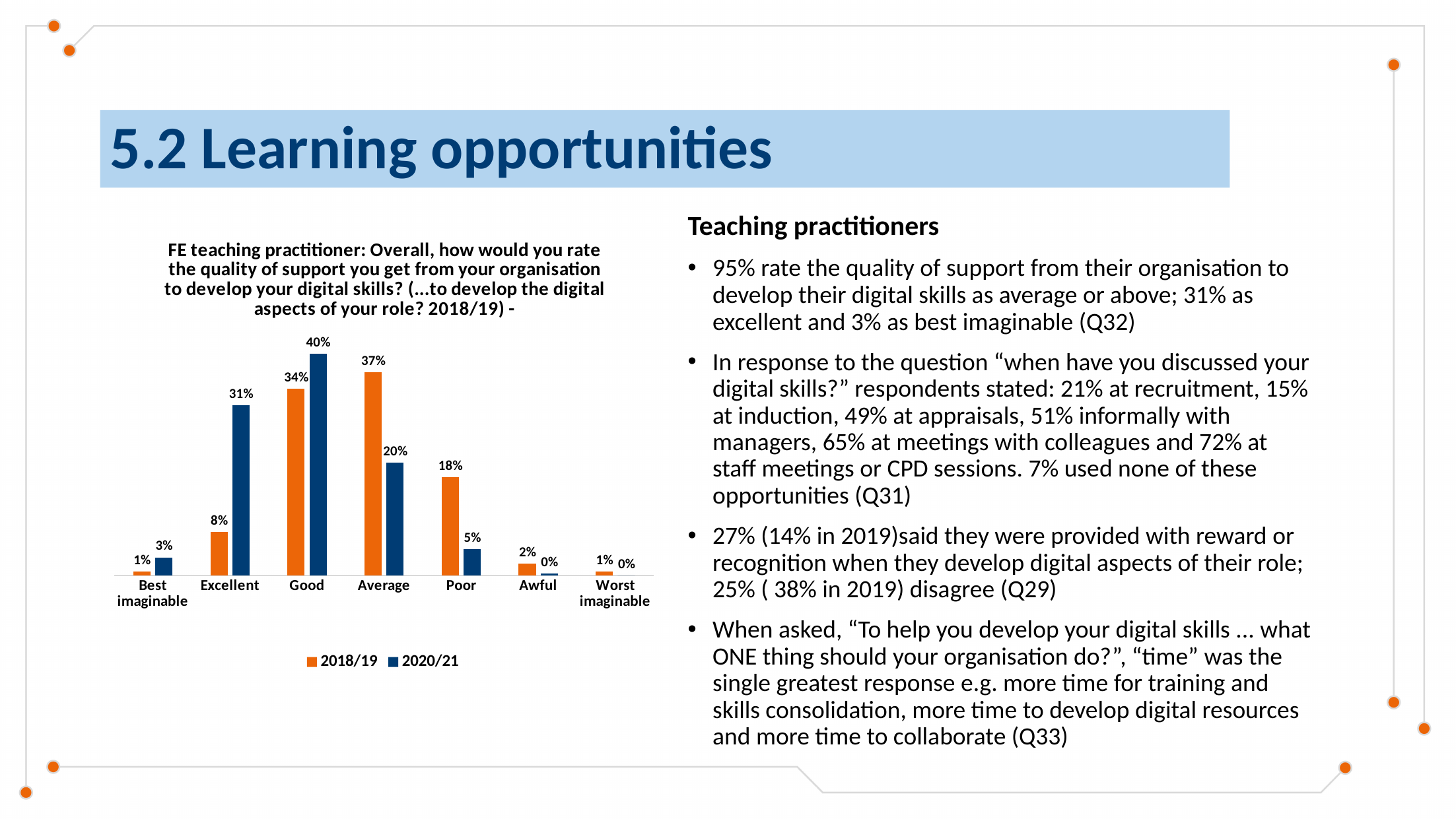
Which category has the highest 2018/19 value? Average What is the difference between the 2018/19 and 2020/21 values for Average? 17% How many series does the legend list? 2 What is the 2020/21 value for Excellent? 31% What kind of chart is shown on the slide? Bar chart What is the 2020/21 value for Good? 40% How many rating categories are shown on the x axis? 7 What is the 2018/19 value for Average? 37% Which category has the highest 2020/21 value? Good What is the difference between the 2018/19 and 2020/21 values for Excellent? 23% Which is larger for Poor: the 2018/19 value or the 2020/21 value? 2018/19 What is the 2018/19 value for Poor? 18%